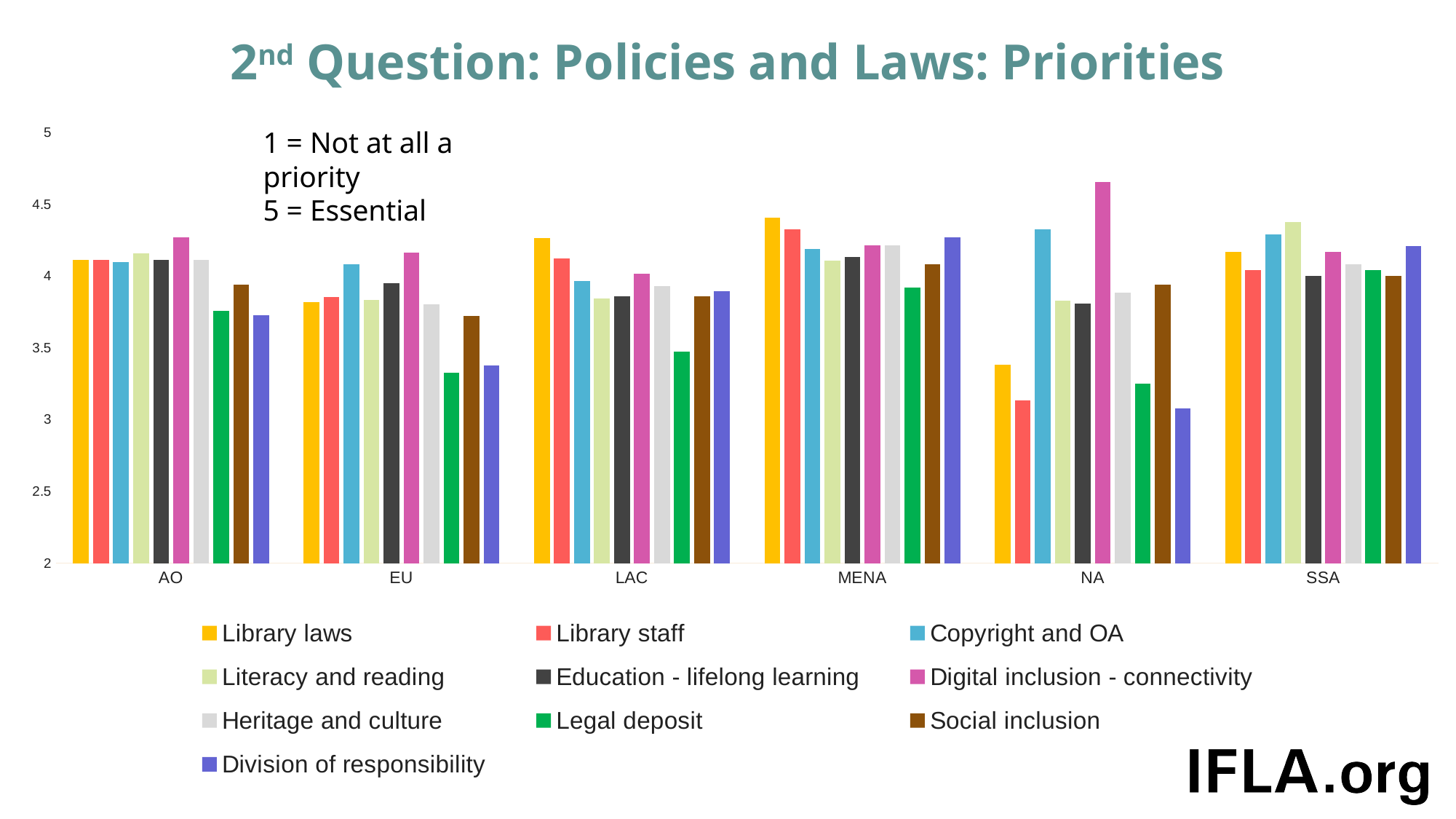
Which series has the lowest value for LAC? Legal deposit Is the value for Library laws in NA greater or less than 3.5? less Is the value for Legal deposit in EU greater or less than 3.5? less Which is larger: the value for Library laws in MENA or the value for Library laws in NA? MENA Which series has the highest value for NA? Digital inclusion - connectivity What is the title of the chart on the slide? 2nd Question: Policies and Laws: Priorities What kind of chart is shown on the slide? bar chart How many series does the chart's legend list? 10 Which series has the lowest value for MENA? Legal deposit Is the value for Copyright and OA in NA greater or less than 4? greater How many regions are shown along the x axis of the chart? 6